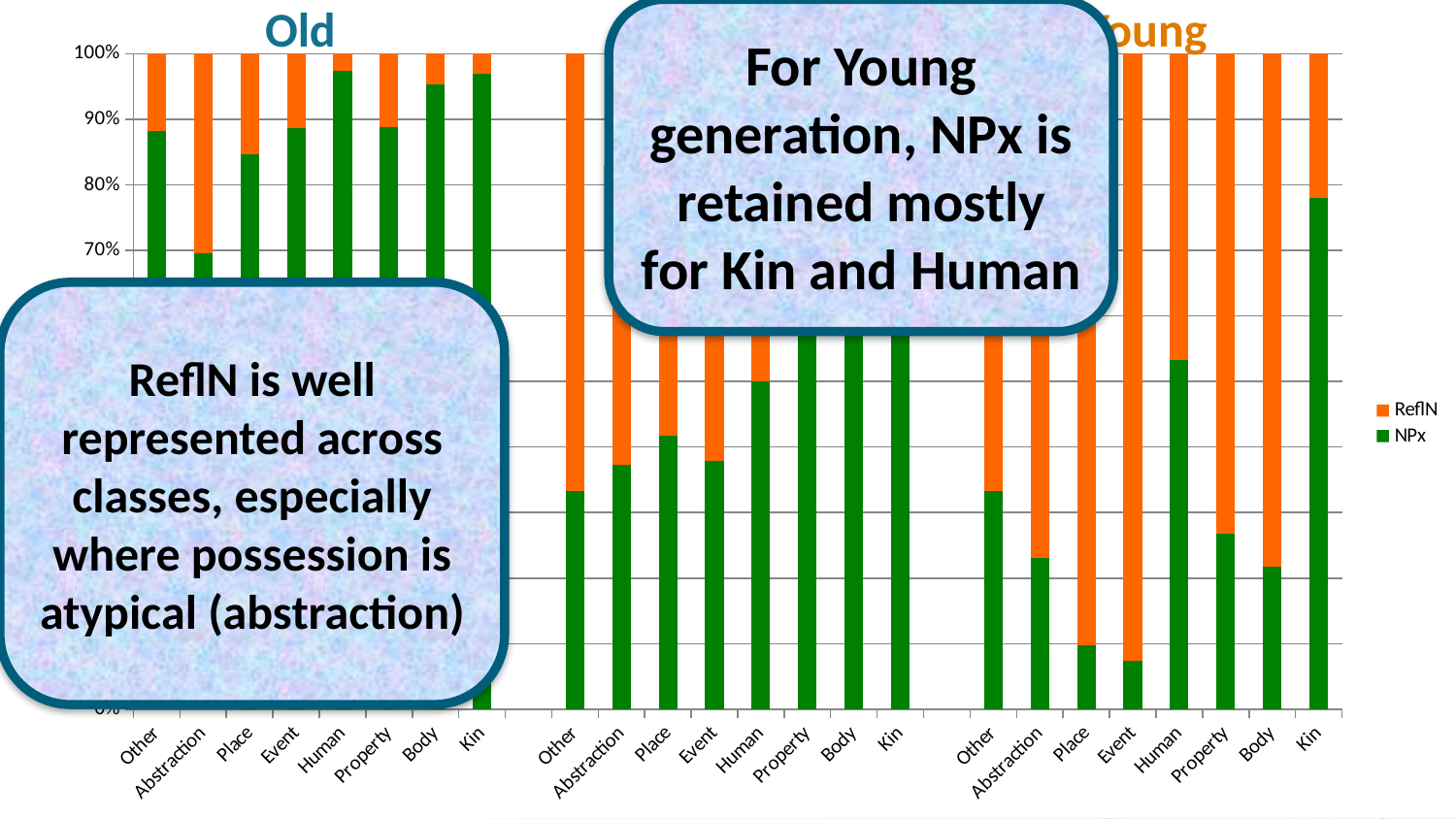
How many series does the legend list? 2 In the Young group, which category has the highest NPx share? Kin In the Old group, is the NPx share for Abstraction greater or less than 80%? less In the Young group, is the NPx share for Place greater or less than 20%? less What kind of chart is shown on the slide? stacked bar chart In the Young group, is the NPx share for Kin greater or less than 70%? greater Which two series are listed in the legend? ReflN and NPx How many categories are shown in the Young group of the chart? 8 What colour represents NPx in the chart? green In the Old group, which category has the lowest NPx share? Abstraction